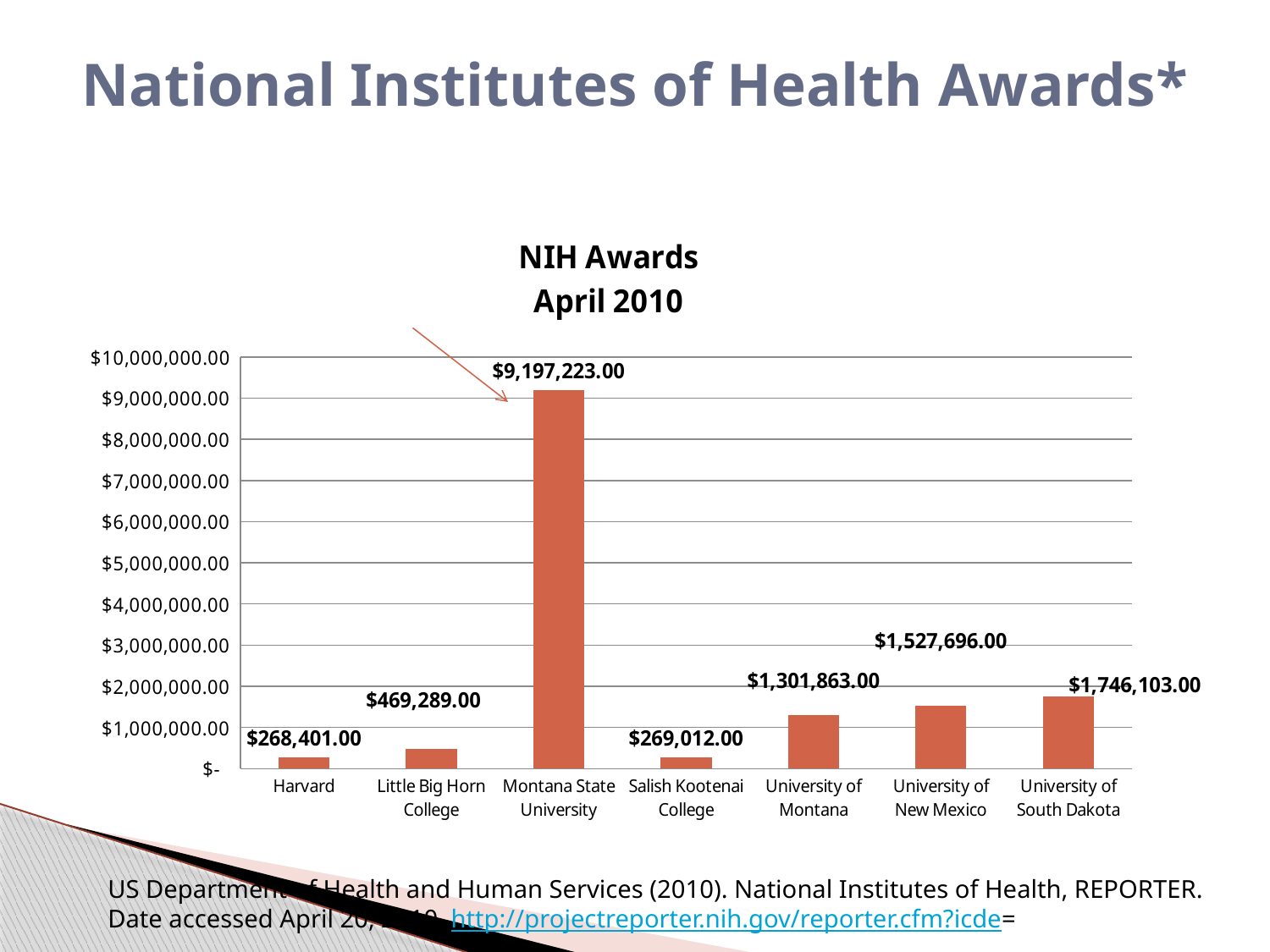
What is the NIH award value for Montana State University? $9,197,223.00 Which institution has the highest NIH award value? Montana State University Is the value for University of Montana greater or less than $1,000,000.00? greater What is the NIH award value for Little Big Horn College? $469,289.00 What is the difference between the NIH award values for University of South Dakota and University of New Mexico? $218,407.00 What type of chart is shown on the slide? Bar chart How many institutions are shown on the x axis of the chart? 7 What is the NIH award value for Harvard? $268,401.00 What is the title of the chart? NIH Awards April 2010 Which has a larger NIH award value, University of Montana or University of South Dakota? University of South Dakota What is the difference between the NIH award values for Little Big Horn College and Harvard? $200,888.00 What is the NIH award value for University of New Mexico? $1,527,696.00